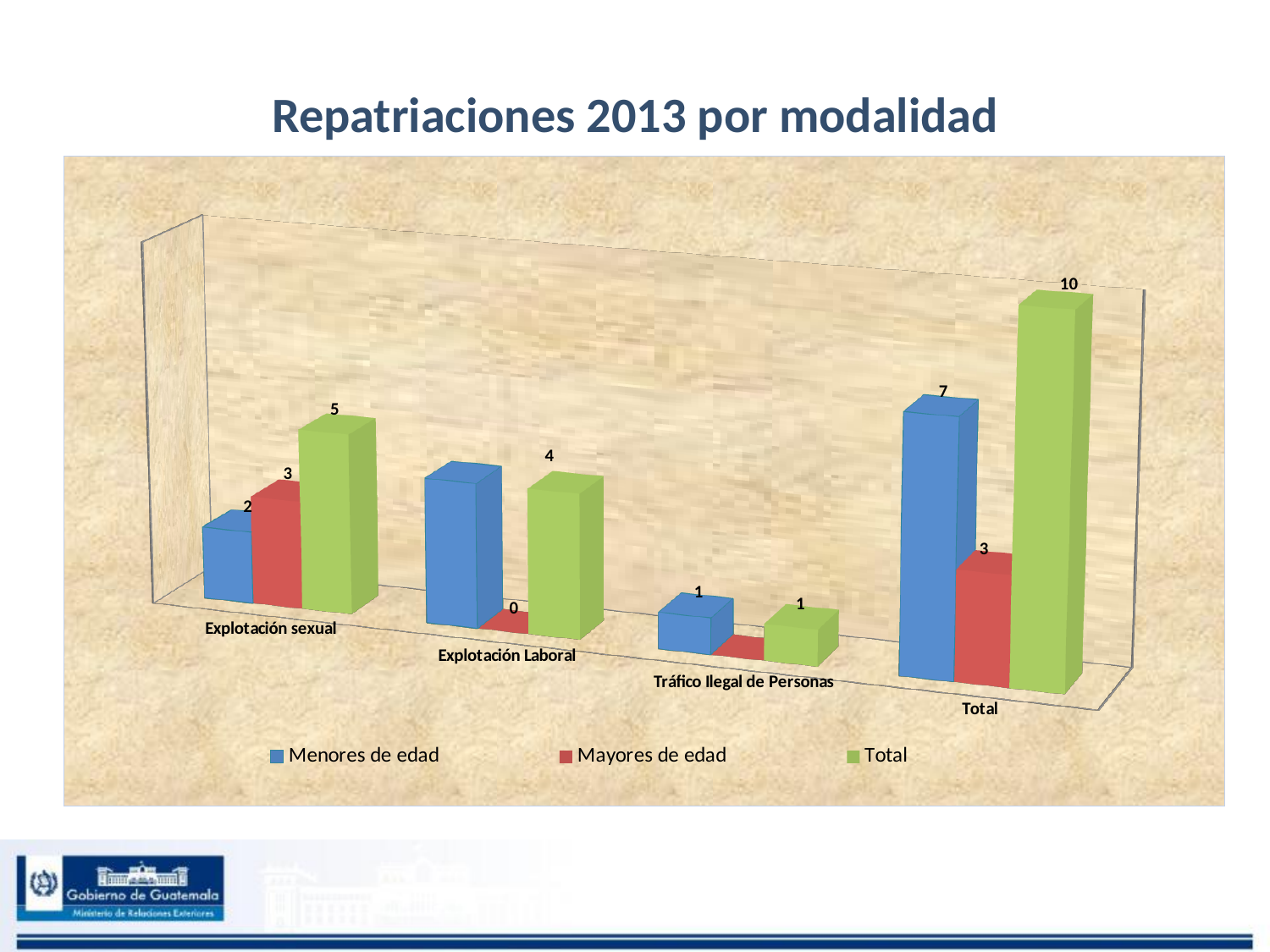
What is the value of Mayores de edad for Explotación Laboral? 0 How many categories are shown on the x axis? 4 How many series does the legend list? 3 In the Total category, what is the difference between Menores de edad and Mayores de edad? 4 What is the value of Menores de edad for the Total category? 7 What is the value of Mayores de edad for Explotación sexual? 3 Among the three modalities (excluding the Total category), which has the highest Total value? Explotación sexual What is the value of Menores de edad for Explotación sexual? 2 Which is larger: Menores de edad for Explotación sexual or Menores de edad for Tráfico Ilegal de Personas? Explotación sexual What is the Total value for Explotación Laboral? 4 What type of chart is shown on the slide? Bar chart What is the Total series value for the Total category? 10